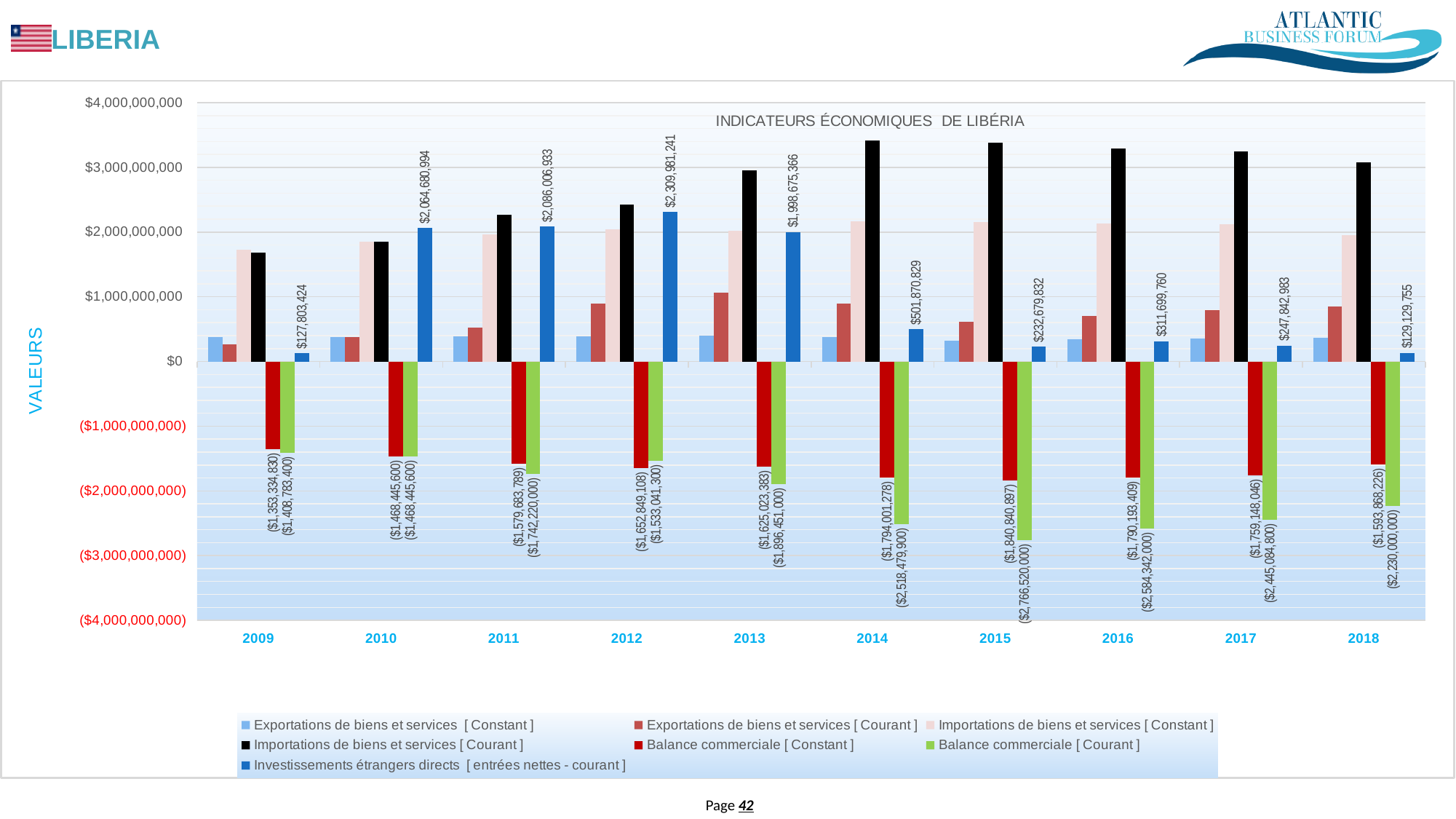
What is the value of Balance commerciale [Courant] for 2018? ($2,230,000,000) What is the title of the chart? INDICATEURS ÉCONOMIQUES DE LIBÉRIA What kind of chart is shown on the slide? bar chart In which year is Investissements étrangers directs [entrées nettes - courant] highest? 2012 Which year has the larger Investissements étrangers directs value, 2014 or 2015? 2014 In which year is Balance commerciale [Courant] lowest (most negative)? 2015 What is the difference between Investissements étrangers directs in 2011 and in 2010? $21,325,939 How many series does the legend list? 7 Is the value of Importations de biens et services [Courant] for 2014 greater or less than $3,000,000,000? greater What is the value of Balance commerciale [Constant] for 2015? ($1,840,840,897) How many years are shown on the x axis? 10 What is the value of Investissements étrangers directs [entrées nettes - courant] for 2012? $2,309,981,241